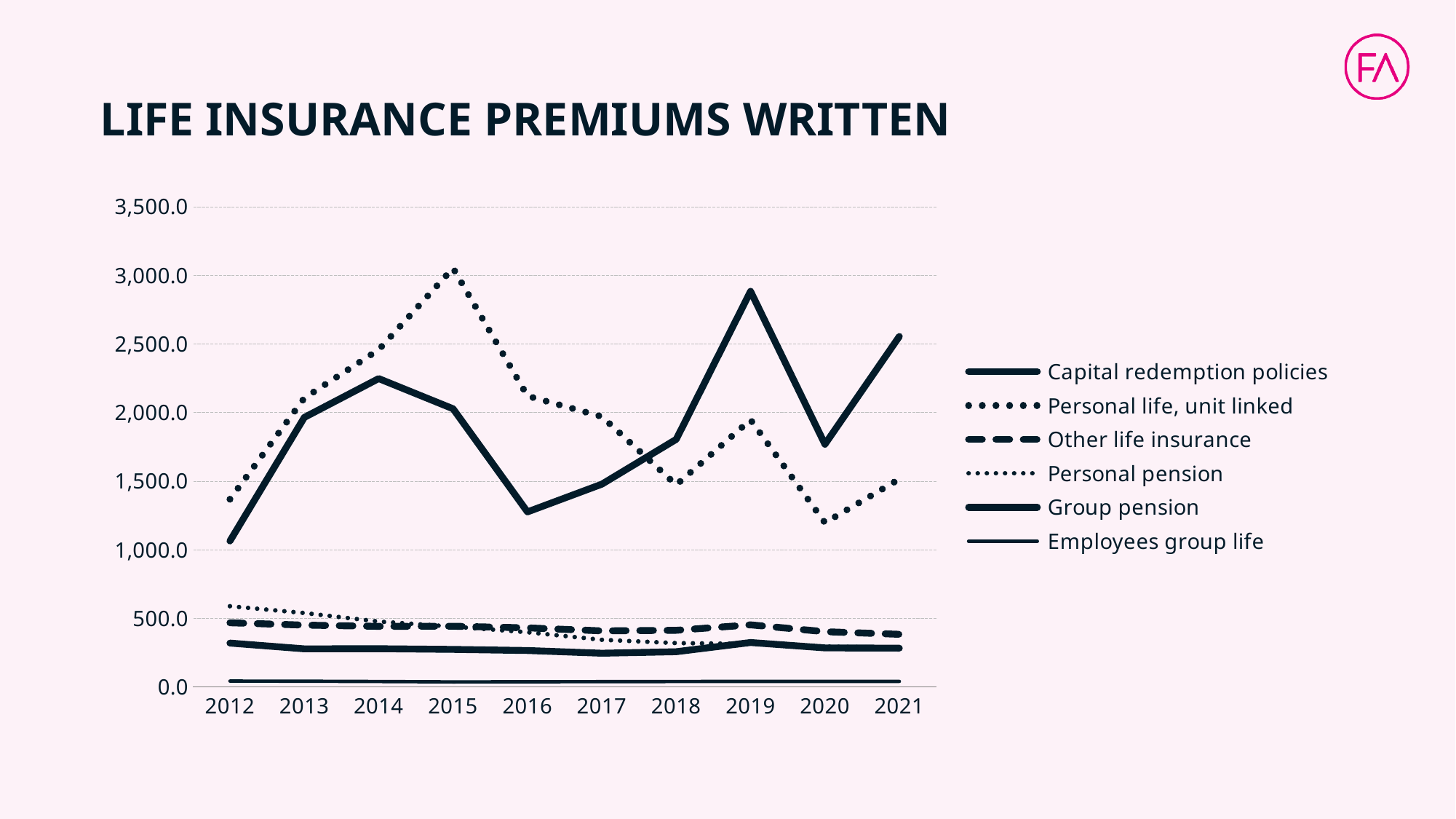
Does Personal pension rise or fall from 2012 to 2021? fall How many series does the legend list? 6 In 2019, which is higher: Capital redemption policies or Personal life, unit linked? Capital redemption policies In which year does Personal life, unit linked reach its highest value? 2015 In 2012, which is higher: Capital redemption policies or Personal life, unit linked? Personal life, unit linked Is the value for Personal life, unit linked in 2015 greater or less than 2,500? greater In which year does Capital redemption policies reach its highest value? 2019 Is the value for Capital redemption policies in 2016 greater or less than 1,500? less In which year is Capital redemption policies at its lowest? 2012 How many years are shown on the x axis? 10 What kind of chart is shown on the slide? line chart In which year is Personal life, unit linked at its lowest? 2020